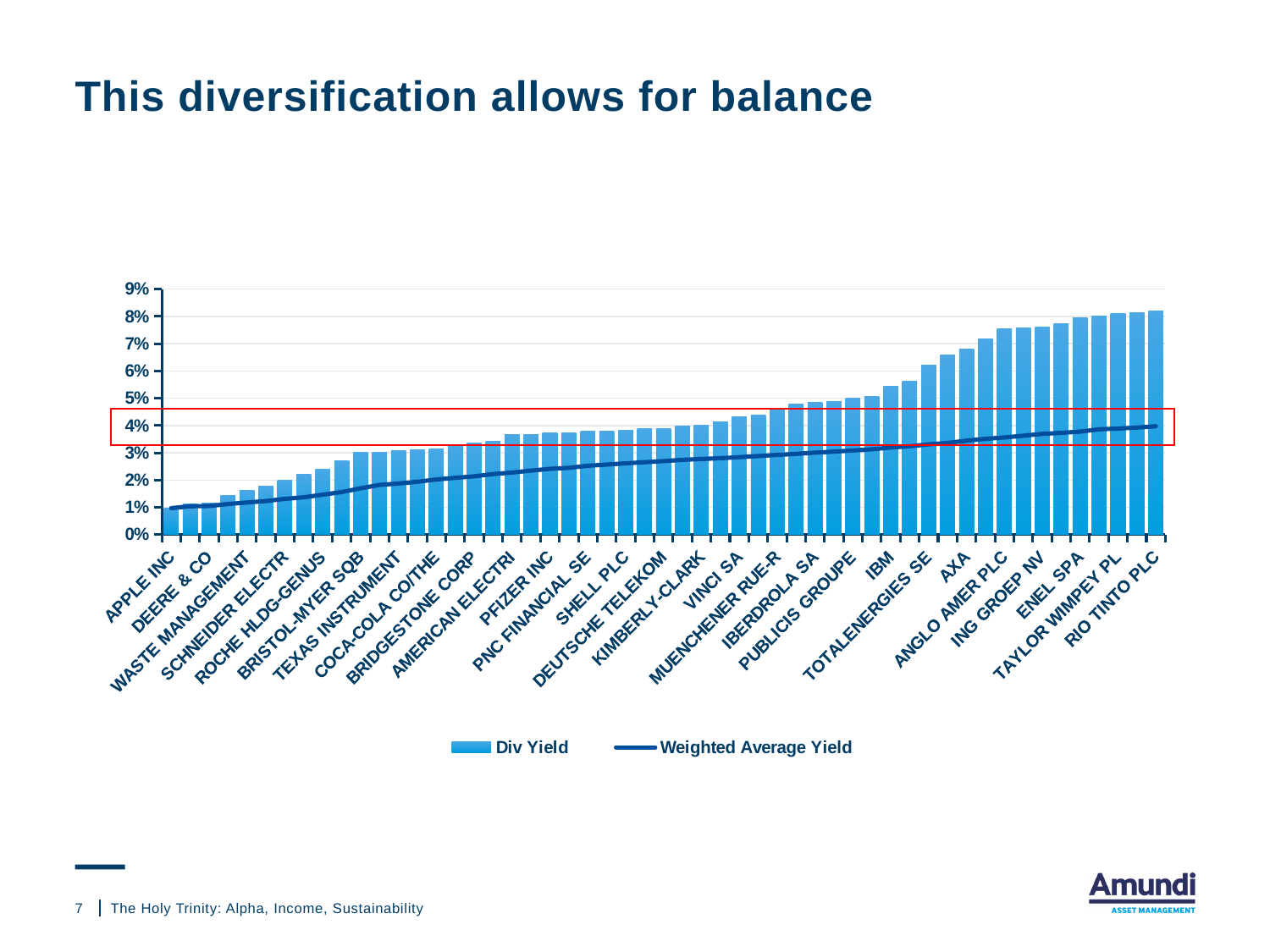
Is the Div Yield for IBM greater or less than 5%? greater Do the Div Yield bars rise or fall from left to right along the x axis? rise Is the Div Yield for SHELL PLC greater or less than 3%? greater Is the Div Yield for APPLE INC greater or less than 2%? less How many series does the legend list? 2 What are the two entries in the chart legend? Div Yield and Weighted Average Yield What is the title of the slide containing the chart? This diversification allows for balance Which has the larger Div Yield, DEERE & CO or ENEL SPA? ENEL SPA Which company has the highest Div Yield? RIO TINTO PLC What kind of chart is shown on the slide? combination bar and line chart Which company has the lowest Div Yield? APPLE INC